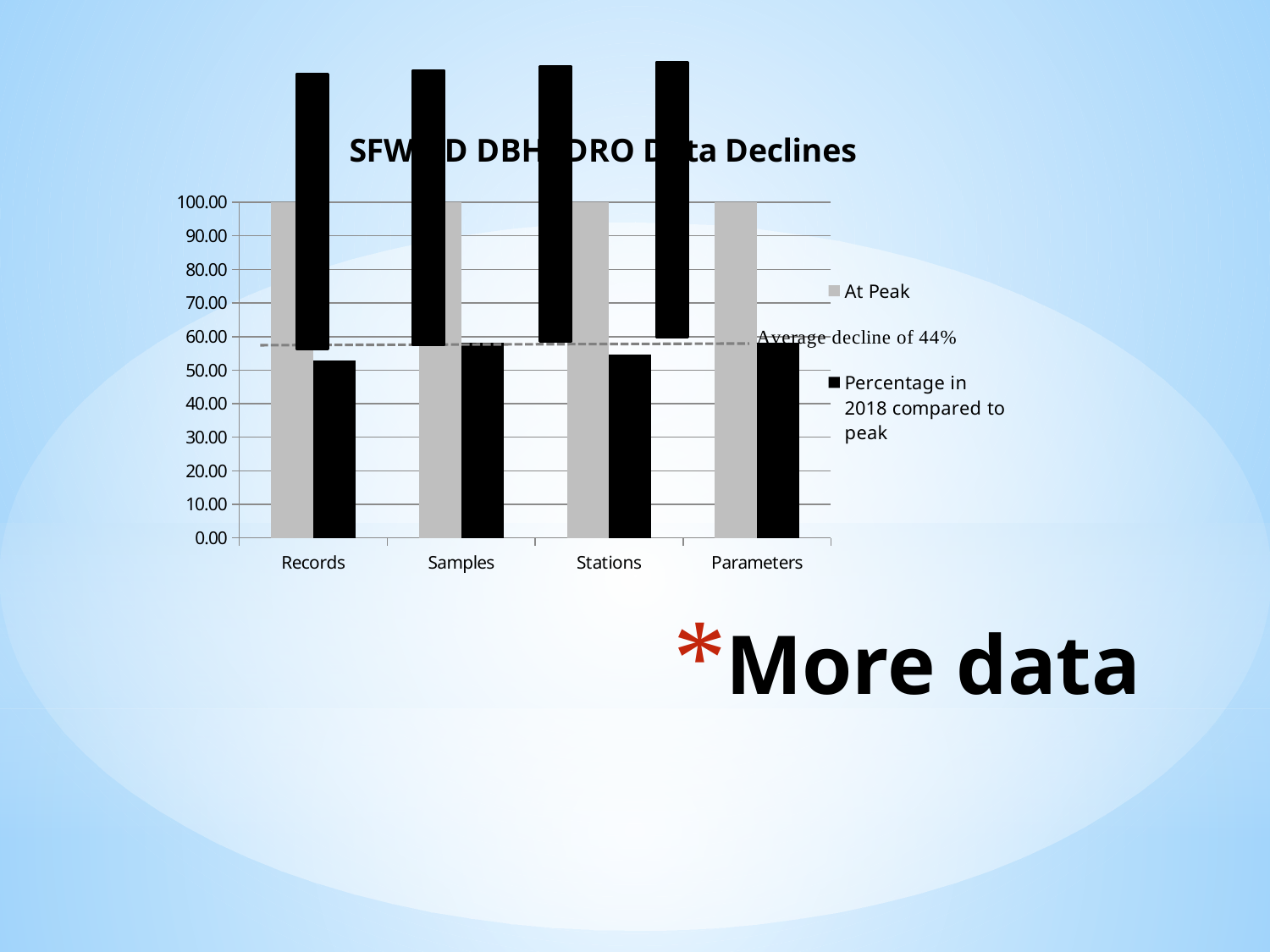
How many categories are shown on the x axis? 4 Is the value of Percentage in 2018 compared to peak for Samples greater or less than 50? greater What average decline does the dashed line label state? Average decline of 44% What is the value of the At Peak series for Records? 100.00 What is the value of the At Peak series for Parameters? 100.00 What kind of chart is shown? Bar chart Which is larger for Percentage in 2018 compared to peak: Records or Samples? Samples Is the value of Percentage in 2018 compared to peak for Stations greater or less than 70? less How many series does the legend list? 2 Is the value of Percentage in 2018 compared to peak for Records greater or less than 50? greater Which is larger for Percentage in 2018 compared to peak: Records or Parameters? Parameters